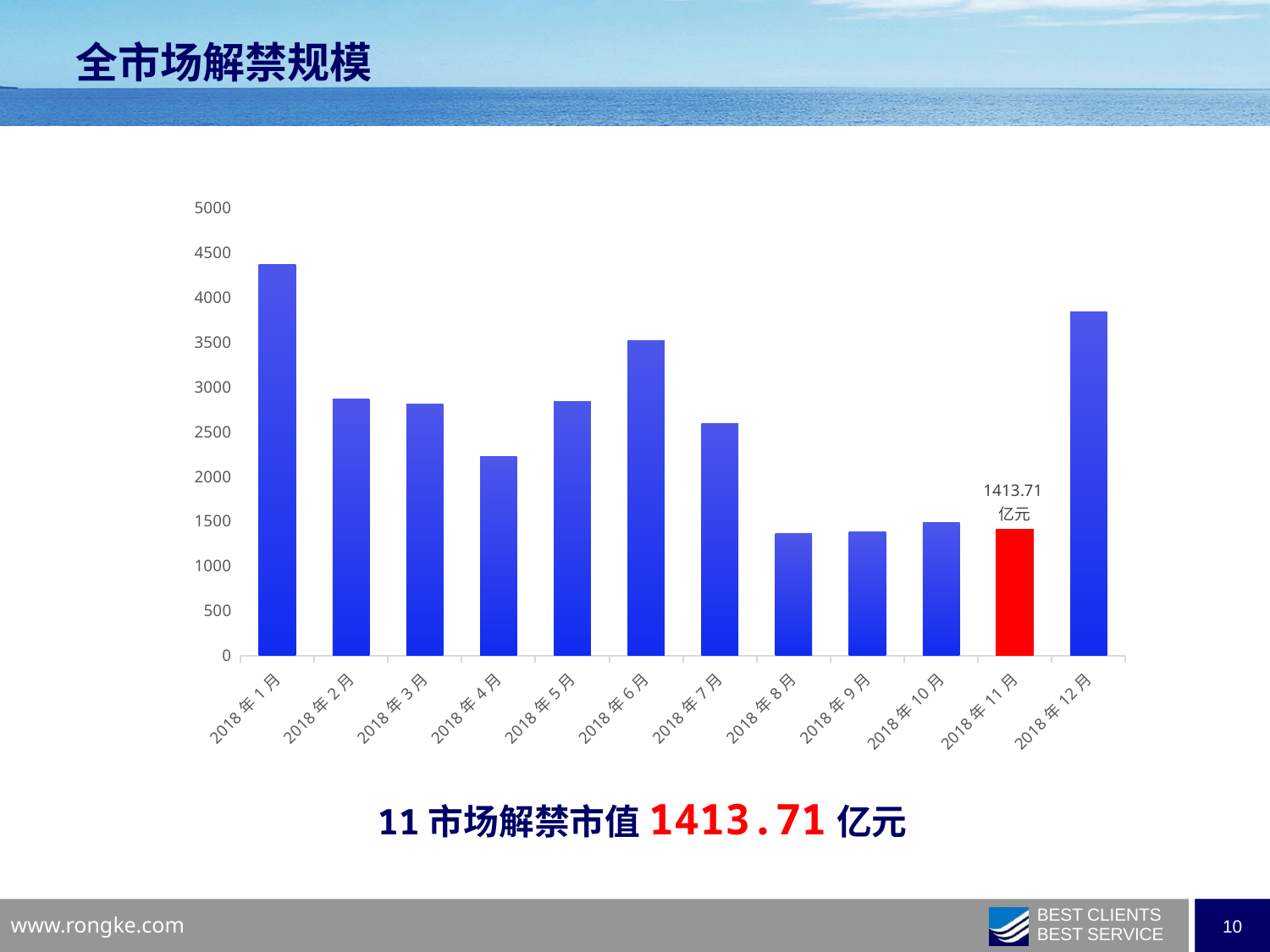
Which month has the highest value? 2018年1月 How many months are shown on the x axis? 12 What is the title of the slide? 全市场解禁规模 Which is larger, the value for 2018年6月 or 2018年7月? 2018年6月 Is the value for 2018年8月 greater or less than 1500? less What kind of chart is shown on the slide? bar chart Which month's bar is coloured red? 2018年11月 Is the value for 2018年4月 greater or less than 2000? greater Which is larger, the value for 2018年2月 or 2018年4月? 2018年2月 What is the value for 2018年11月? 1413.71 亿元 Is the value for 2018年1月 greater or less than 4000? greater